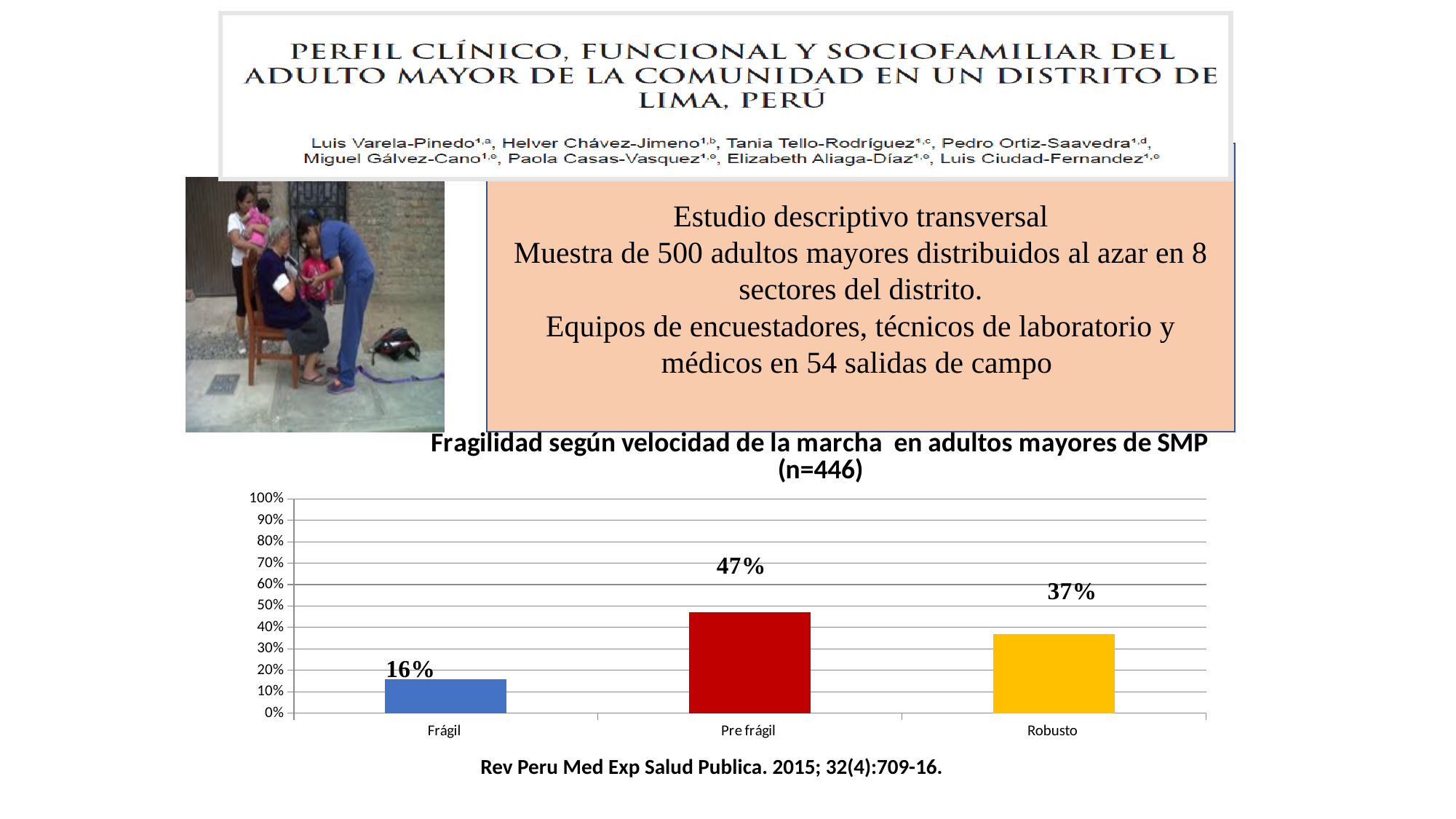
Which is larger, the value for Frágil or the value for Robusto? Robusto What is the value for Frágil? 16% What is the value for Robusto? 37% Which category has the lowest value? Frágil How many categories are shown on the chart? 3 What is the difference between the values for Pre frágil and Robusto? 10% What is the difference between the values for Robusto and Frágil? 21% What kind of chart is shown on the slide? bar chart What is the value for Pre frágil? 47% Is the value for Pre frágil greater or less than 50%? less What is the sample size (n) stated in the chart title? 446 Which category has the highest value? Pre frágil